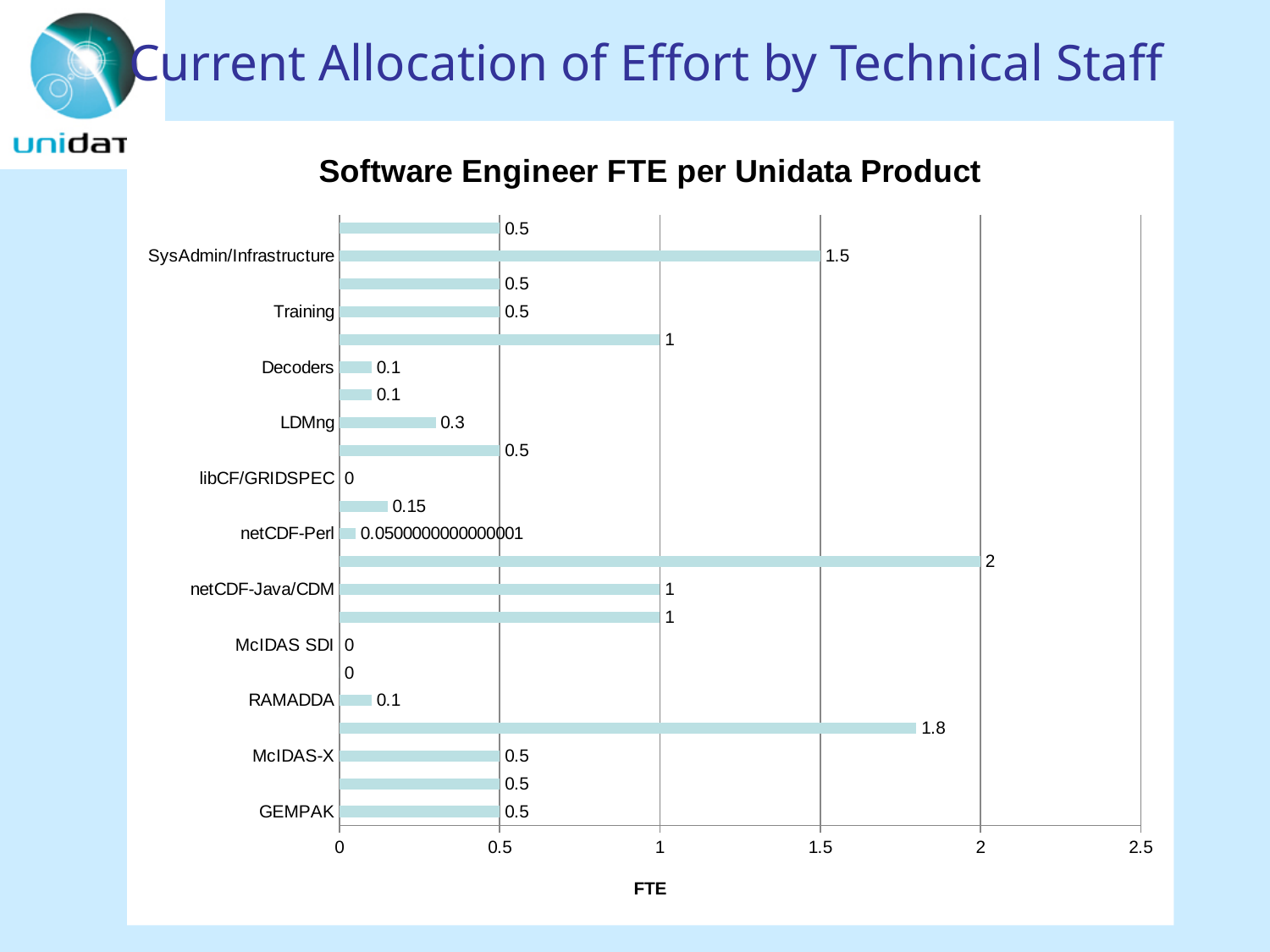
What is the title of the chart? Software Engineer FTE per Unidata Product What is the FTE value for GEMPAK? 0.5 What is the difference in FTE between SysAdmin/Infrastructure and Training? 1 What is the FTE value for RAMADDA? 0.1 What is the FTE value for netCDF-Java/CDM? 1 Which has a higher FTE value, LDMng or Decoders? LDMng What is the FTE value for libCF/GRIDSPEC? 0 What is the largest FTE value labelled on any bar in the chart? 2 What kind of chart is shown on the slide? Bar chart What is the FTE value for SysAdmin/Infrastructure? 1.5 What is the FTE value for Training? 0.5 What is the FTE value for LDMng? 0.3